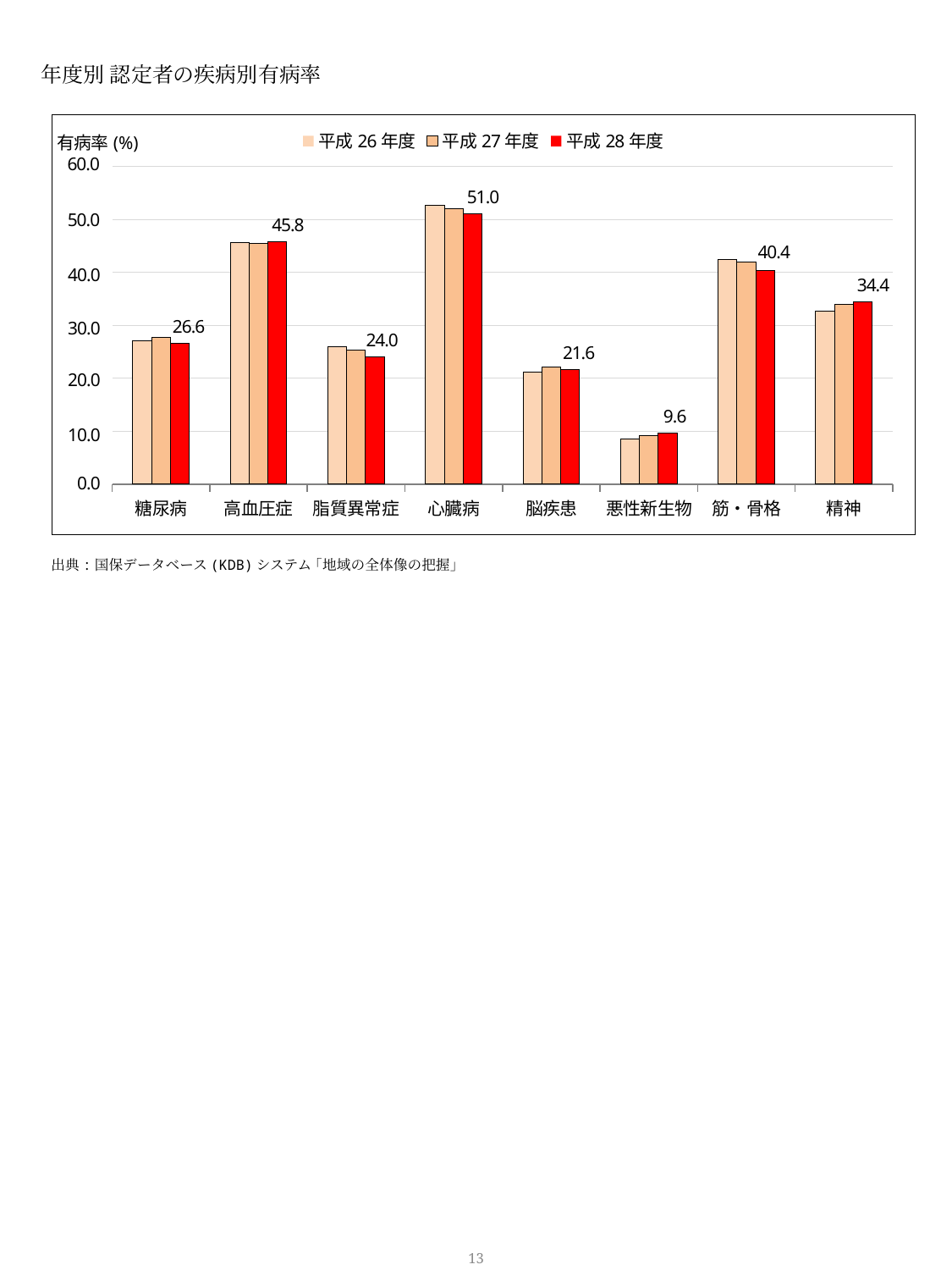
What is the 平成28年度 value for 悪性新生物? 9.6 Which category has the lowest 平成28年度 value? 悪性新生物 What is the difference between the 平成28年度 values for 高血圧症 and 脂質異常症? 21.8 What is the 平成28年度 value for 心臓病? 51.0 Which category has the highest 平成28年度 value? 心臓病 Is the 平成26年度 value for 悪性新生物 greater or less than 10.0? less Which is larger for 平成28年度: 糖尿病 or 精神? 精神 What kind of chart is shown? bar chart Is the 平成26年度 value for 心臓病 greater or less than 50.0? greater What is the 平成28年度 value for 筋・骨格? 40.4 How many disease categories are shown on the x axis? 8 How many series does the legend list? 3